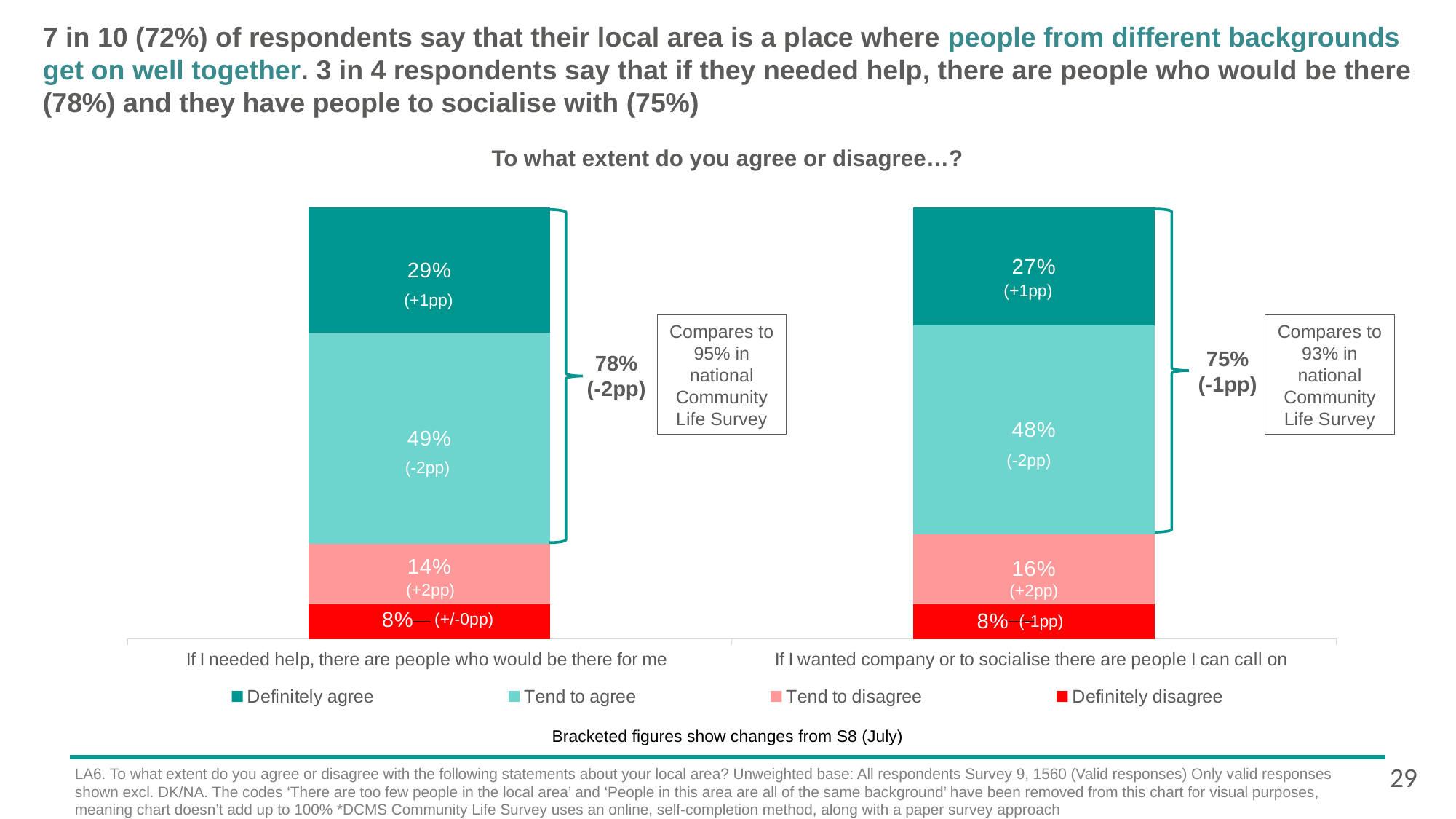
How many statements (categories) are plotted on the chart? 2 What percentage of respondents 'Definitely agree' with 'If I wanted company or to socialise there are people I can call on'? 27% Which response category is the smallest segment for 'If I wanted company or to socialise there are people I can call on'? Definitely disagree What is the combined 'Definitely agree' and 'Tend to agree' total for 'If I needed help, there are people who would be there for me'? 78% What is the difference between the 'Tend to agree' values for the two statements? 1% What percentage of respondents 'Tend to agree' with 'If I needed help, there are people who would be there for me'? 49% Which response category is the largest segment for 'If I needed help, there are people who would be there for me'? Tend to agree What kind of chart is shown on the slide? Stacked bar chart What is the title of the chart? To what extent do you agree or disagree…? How many series does the legend list? 4 Which statement has the larger 'Definitely agree' share? If I needed help, there are people who would be there for me What percentage of respondents 'Tend to disagree' with 'If I wanted company or to socialise there are people I can call on'? 16%